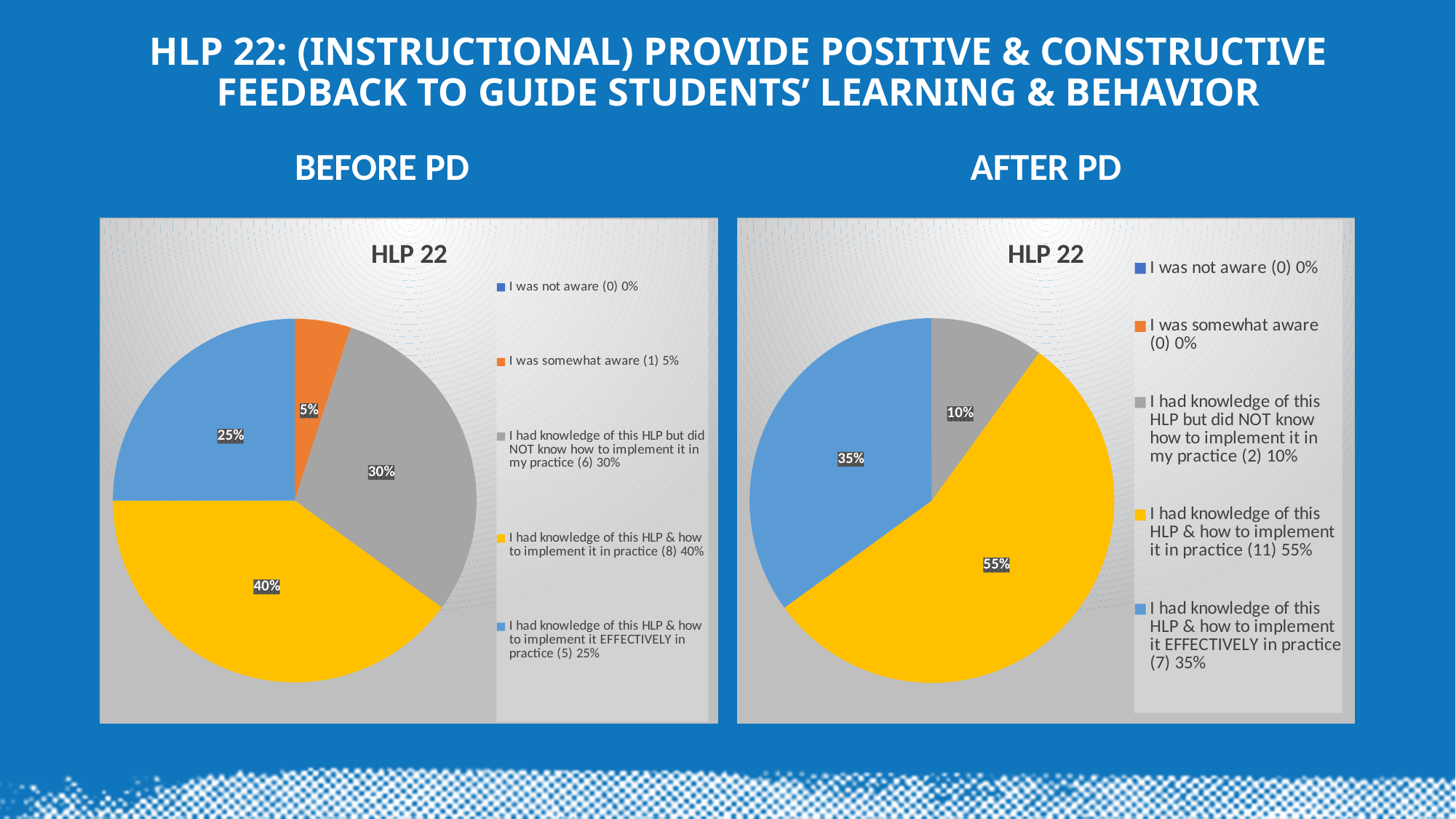
What is the title shown on both charts? HLP 22 In the AFTER PD chart, how many respondents said they had knowledge of this HLP but did NOT know how to implement it in their practice? 2 In the BEFORE PD chart, what percentage of respondents said they were somewhat aware? 5% In the AFTER PD chart, which category has the largest share of the pie? I had knowledge of this HLP & how to implement it in practice In the AFTER PD chart, what percentage of respondents said they had knowledge of this HLP & how to implement it EFFECTIVELY in practice? 35% In the BEFORE PD chart, what percentage of respondents said they had knowledge of this HLP & how to implement it in practice? 40% How many categories does the legend of the AFTER PD chart list? 5 In the BEFORE PD chart, what colour is the slice for 'I had knowledge of this HLP & how to implement it in practice'? Yellow In the BEFORE PD chart, which is larger: the share for 'I had knowledge of this HLP but did NOT know how to implement it in my practice' or the share for 'I had knowledge of this HLP & how to implement it EFFECTIVELY in practice'? I had knowledge of this HLP but did NOT know how to implement it in my practice What type of chart is used in the BEFORE PD panel? Pie chart What is the difference between the AFTER PD and BEFORE PD percentages for 'I had knowledge of this HLP & how to implement it in practice'? 15% In the BEFORE PD chart, which category with a non-zero share has the smallest slice? I was somewhat aware